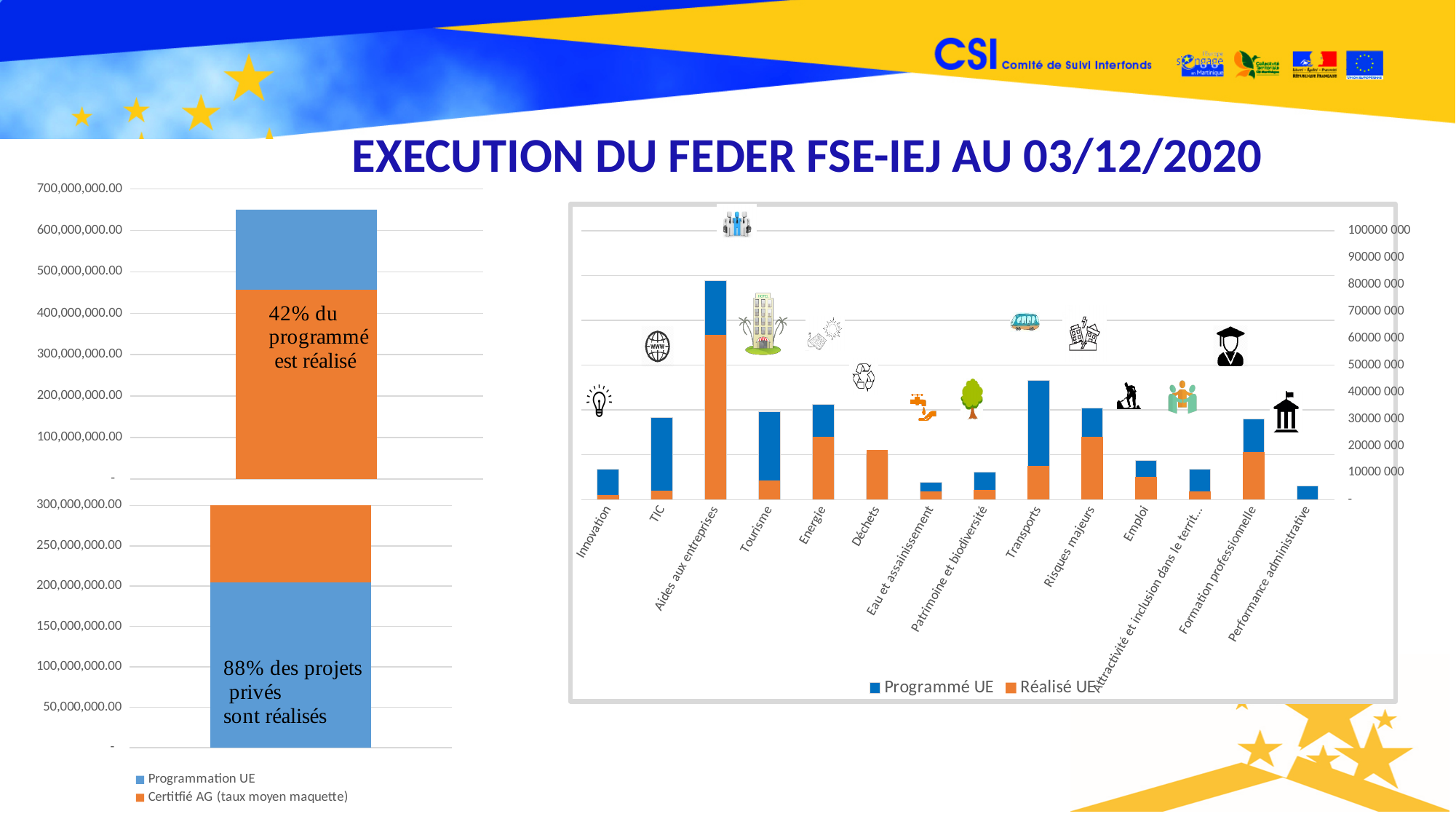
In the chart on the right, is the total bar for Transports greater or less than 30000 000? greater In the chart on the right, is the total bar for Performance administrative greater or less than 10000 000? less In the chart on the right, what are the two legend entries? Programmé UE and Réalisé UE In the bottom-left chart, is the top of the stacked bar greater or less than 250,000,000.00? greater In the chart on the right, which has the taller stacked bar, Transports or Emploi? Transports In the top-left chart, what percentage of the programmed amount is stated as realised? 42% In the chart on the right, how many series does the legend list? 2 What kind of chart is the chart on the right? Stacked bar chart In the chart on the right, which category has the tallest stacked bar? Aides aux entreprises In the chart on the right, which category has the shortest stacked bar? Performance administrative In the chart on the right, how many categories are shown on the x axis? 14